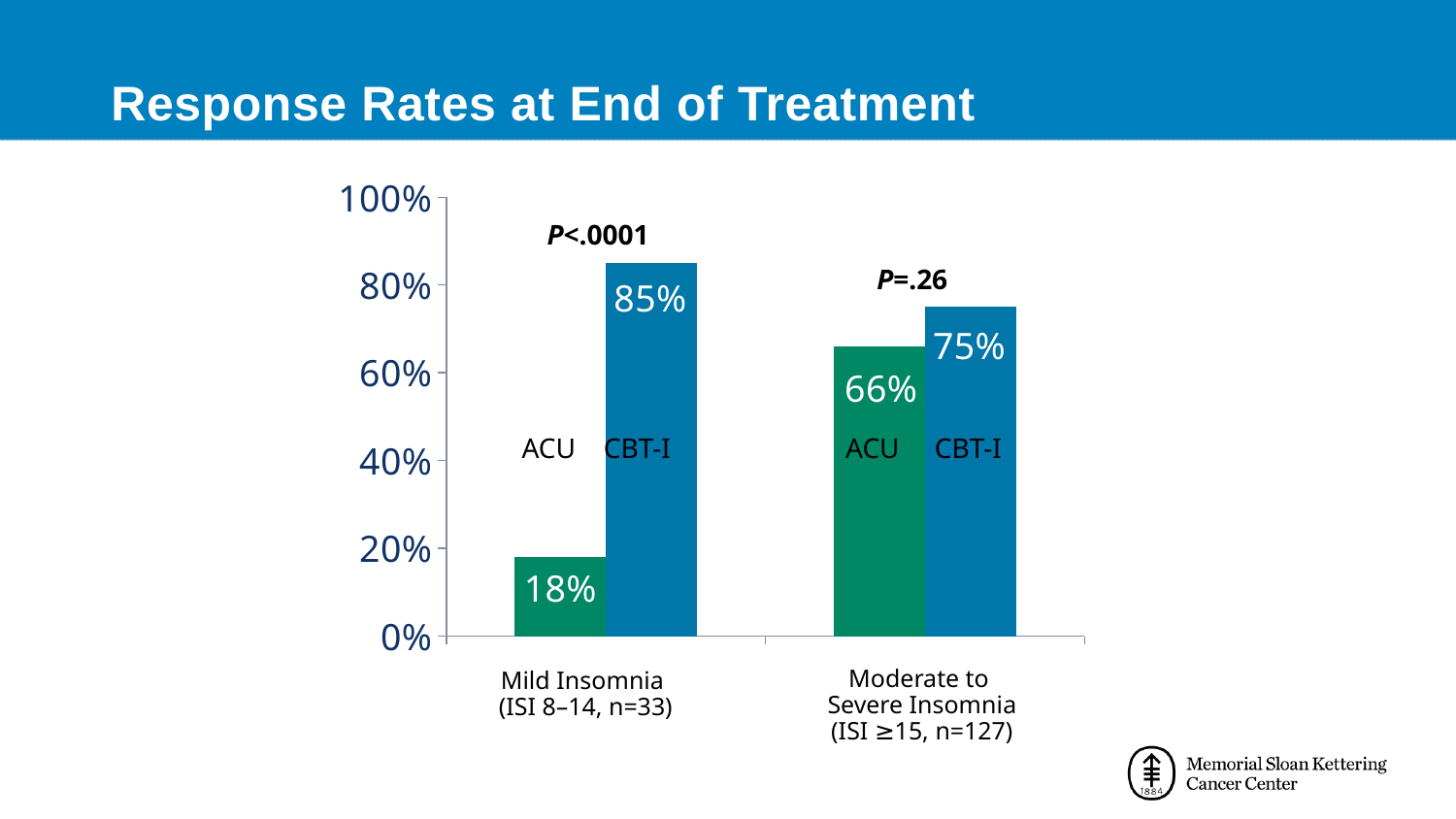
Which has a higher response rate in the Moderate to Severe Insomnia group, ACU or CBT-I? CBT-I What is the response rate for ACU in the Moderate to Severe Insomnia group? 66% Which bar shows the highest response rate? CBT-I, Mild Insomnia What is the difference between the CBT-I and ACU response rates in the Moderate to Severe Insomnia group? 9% What is the difference between the CBT-I and ACU response rates in the Mild Insomnia group? 67% What is the title of the chart? Response Rates at End of Treatment What is the response rate for CBT-I in the Mild Insomnia group? 85% What is the response rate for ACU in the Mild Insomnia group? 18% What is the response rate for CBT-I in the Moderate to Severe Insomnia group? 75% Which bar shows the lowest response rate? ACU, Mild Insomnia What kind of chart is shown on the slide? Bar chart How many insomnia groups are shown on the x axis? 2